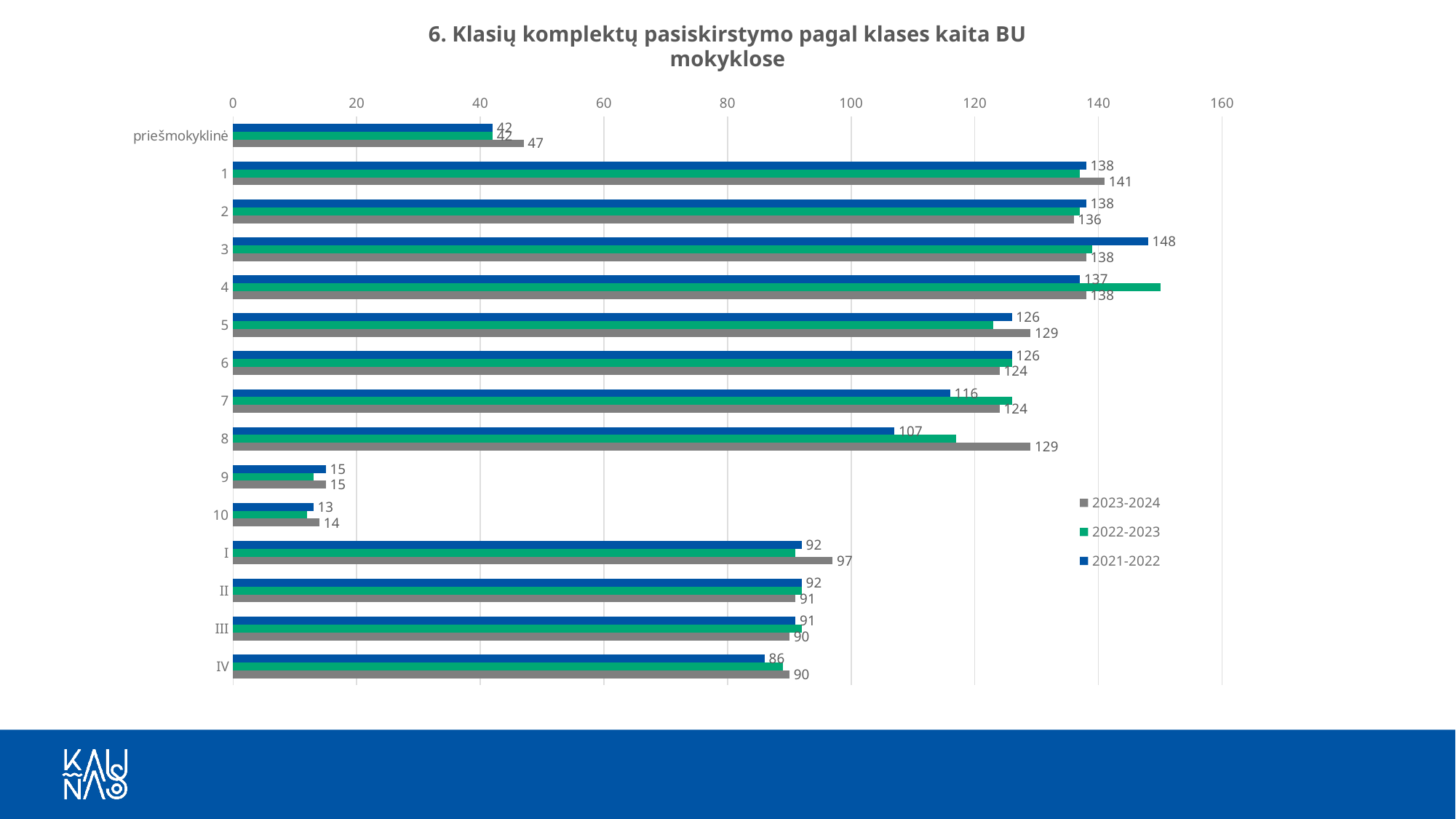
Is the 2022-2023 value for class 4 greater or less than 140? greater For class 1, which series has the larger value: 2023-2024 or 2021-2022? 2023-2024 What is the 2023-2024 value for class 8? 129 Which category has the lowest 2021-2022 value? 10 What is the 2021-2022 value for class 3? 148 What colour represents the 2022-2023 series in the legend? green What is the 2023-2024 value for priešmokyklinė? 47 How many class categories are shown on the vertical axis? 15 How many series does the legend list? 3 For class 8, what is the difference between the 2023-2024 value and the 2021-2022 value? 22 Which category has the highest 2021-2022 value? 3 What kind of chart is shown on the slide? bar chart